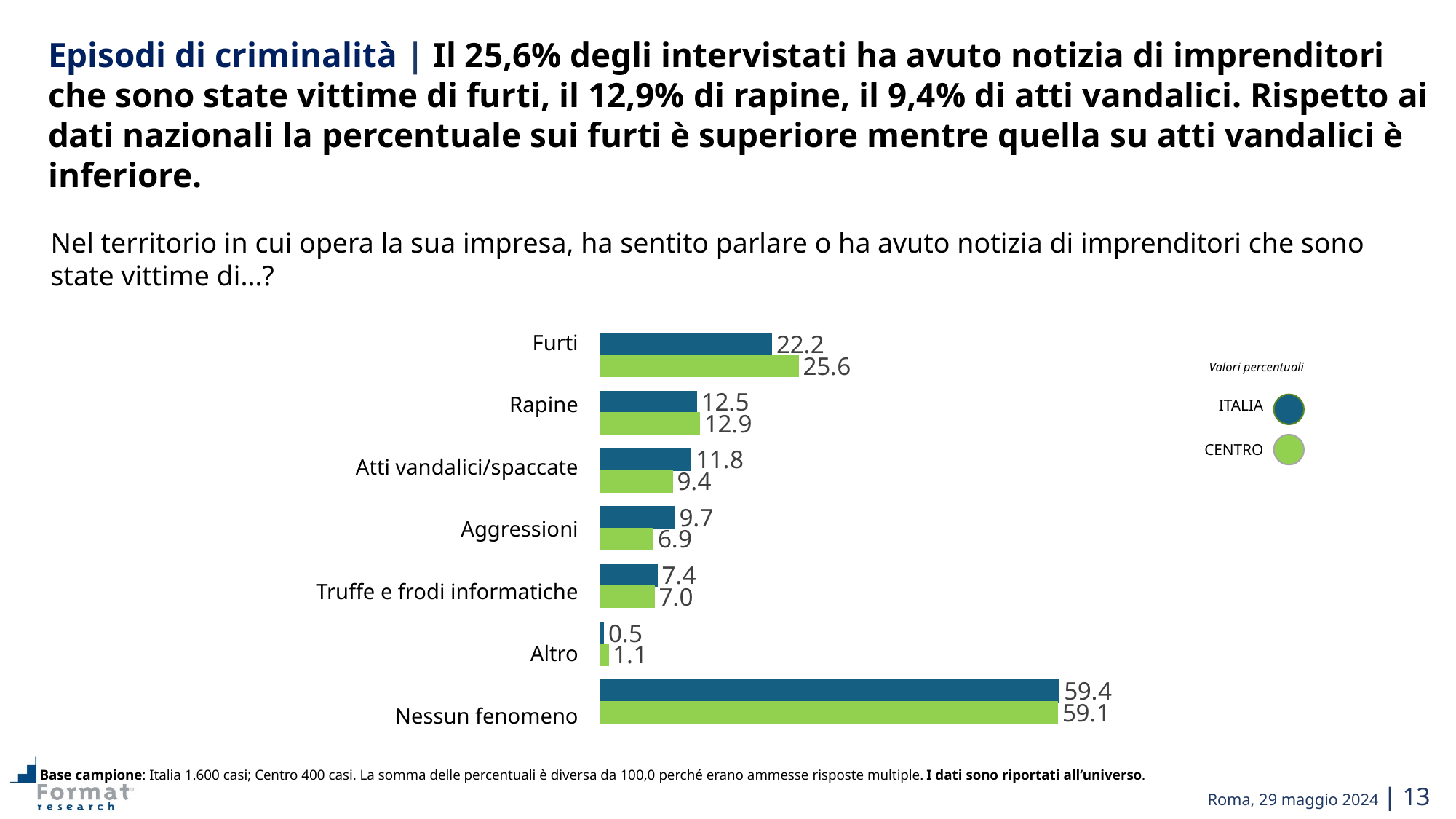
Which category has the highest CENTRO value? Nessun fenomeno What is the CENTRO value for Aggressioni? 6.9 What is the ITALIA value for Rapine? 12.5 Which category has the lowest ITALIA value? Altro What is the difference between the CENTRO and ITALIA values for Furti? 3.4 What kind of chart is shown on the slide? Bar chart What is the ITALIA value for Nessun fenomeno? 59.4 What is the difference between the ITALIA and CENTRO values for Atti vandalici/spaccate? 2.4 How many categories are shown in the chart? 7 What is the CENTRO value for Furti? 25.6 For Aggressioni, which series has the larger value, ITALIA or CENTRO? ITALIA How many series does the legend list? 2